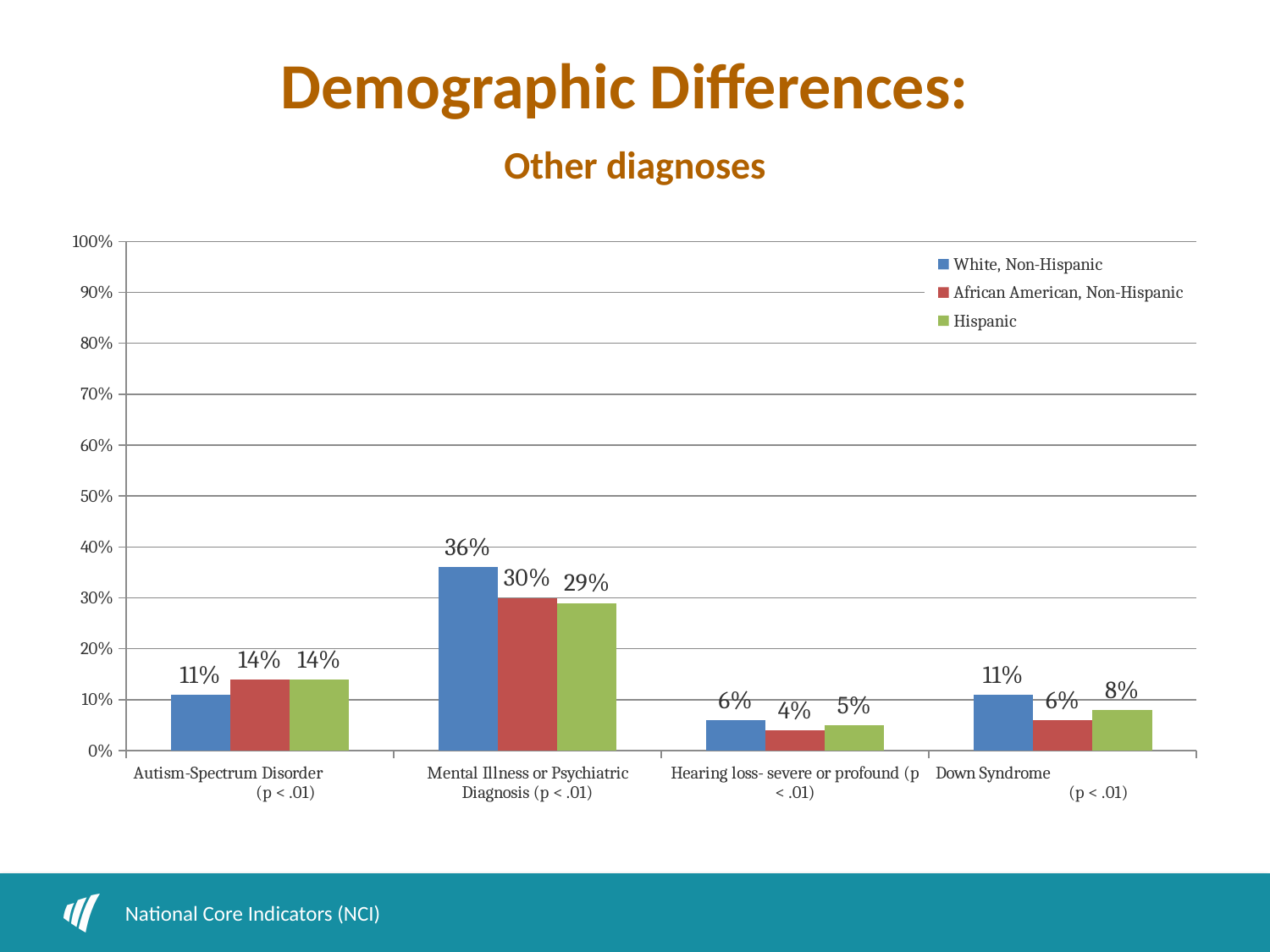
What is the value for African American, Non-Hispanic in the Hearing loss- severe or profound category? 4% Which category has the highest value for the White, Non-Hispanic series? Mental Illness or Psychiatric Diagnosis Which colour represents the Hispanic series? green In the Autism-Spectrum Disorder category, which is larger: the White, Non-Hispanic value or the African American, Non-Hispanic value? African American, Non-Hispanic What is the value for White, Non-Hispanic in the Mental Illness or Psychiatric Diagnosis category? 36% Is the value for African American, Non-Hispanic in the Mental Illness or Psychiatric Diagnosis category greater or less than 20%? greater What is the difference between the White, Non-Hispanic and Hispanic values in the Mental Illness or Psychiatric Diagnosis category? 7% What is the value for Hispanic in the Down Syndrome category? 8% What kind of chart is shown on the slide? bar chart How many series does the legend list? 3 Which category has the lowest value for the Hispanic series? Hearing loss- severe or profound How many diagnosis categories are shown on the x axis? 4